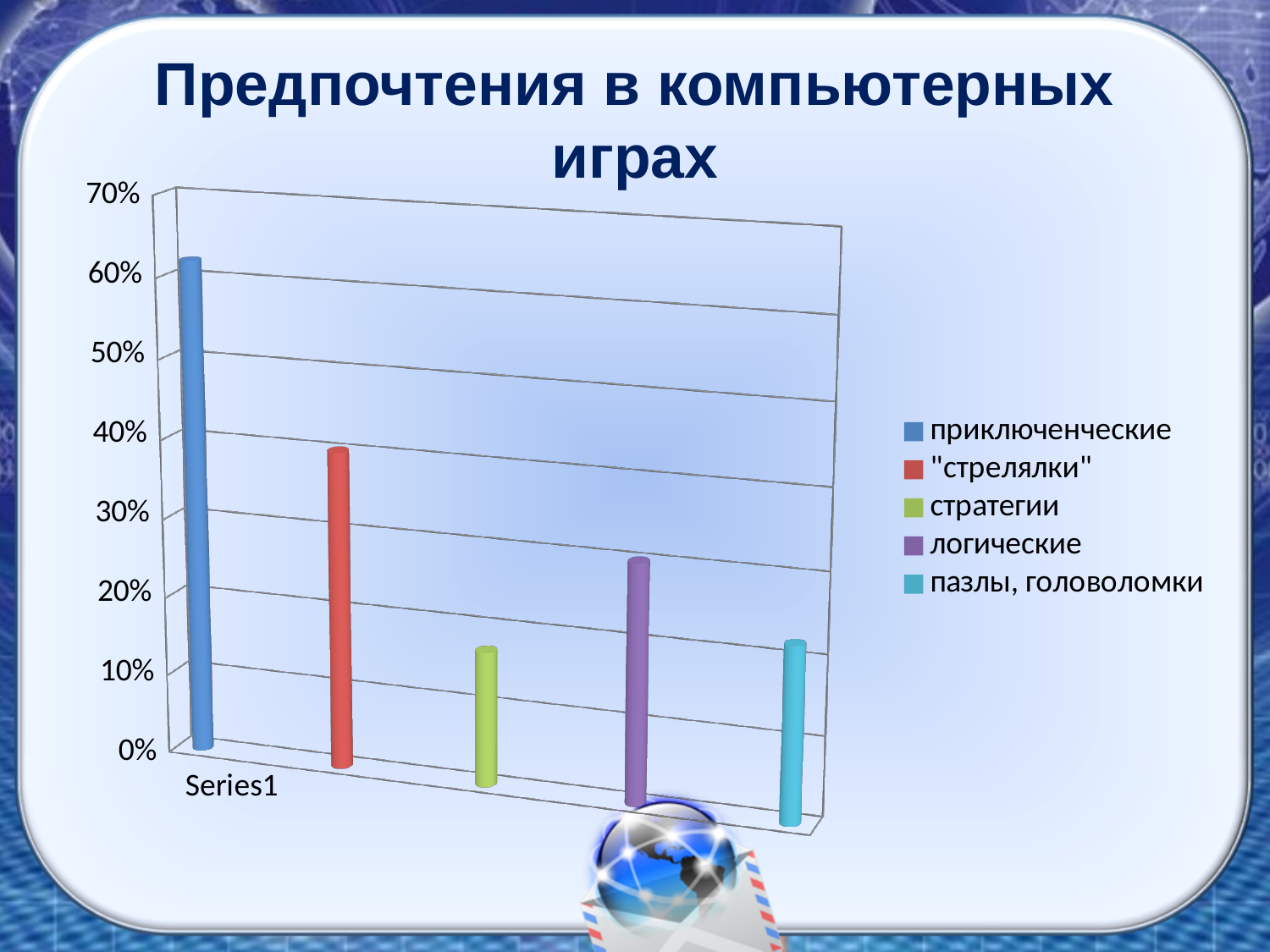
Is the value for стратегии greater or less than 20%? less Is the value for "стрелялки" greater or less than 30%? greater Which is larger, the value for логические or the value for стратегии? логические Which is larger, the value for приключенческие or the value for "стрелялки"? приключенческие What kind of chart is shown on the slide? bar chart Is the value for логические greater or less than 20%? greater How many bars are plotted in the chart? 5 Which game type has the highest bar? приключенческие What is the title of the chart? Предпочтения в компьютерных играх How many entries does the legend list? 5